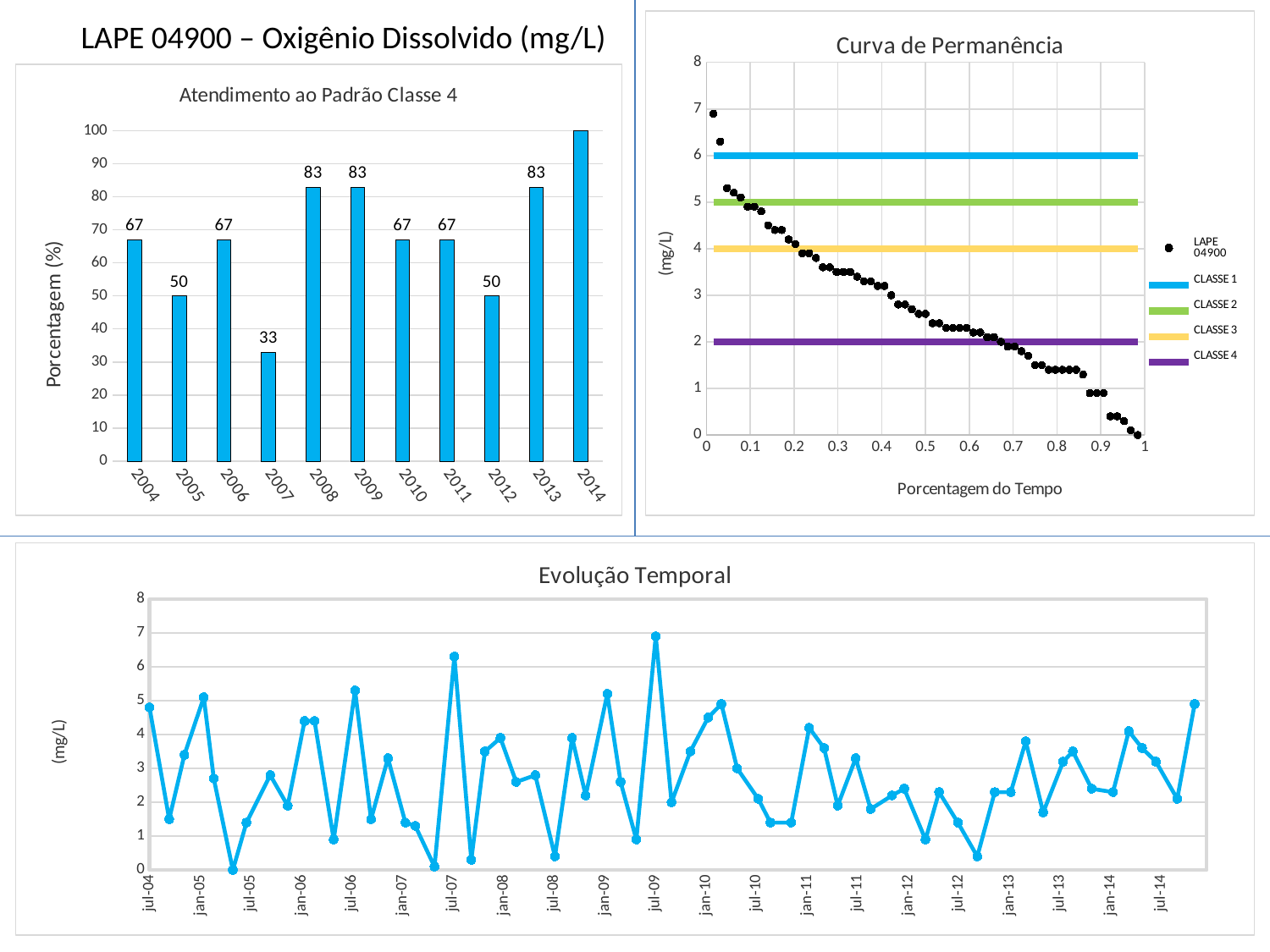
In the 'Curva de Permanência' chart, at what mg/L level is the CLASSE 4 line drawn? 2 In the 'Atendimento ao Padrão Classe 4' chart, which is larger, the value for 2005 or the value for 2006? 2006 In the 'Curva de Permanência' chart, do the LAPE 04900 values rise or fall as the percentage of time increases? fall In the 'Atendimento ao Padrão Classe 4' chart, what is the value for 2008? 83 In the 'Atendimento ao Padrão Classe 4' chart, what is the value for 2007? 33 How many years are shown in the 'Atendimento ao Padrão Classe 4' chart? 11 How many entries does the legend of the 'Curva de Permanência' chart list? 5 What kind of chart is 'Atendimento ao Padrão Classe 4'? bar chart In the 'Atendimento ao Padrão Classe 4' chart, what is the difference between the values for 2013 and 2012? 33 In the 'Atendimento ao Padrão Classe 4' chart, which year has the lowest value? 2007 In the 'Atendimento ao Padrão Classe 4' chart, which year has the highest value? 2014 In the 'Evolução Temporal' chart, is the value at jul-09 greater or less than 6? greater